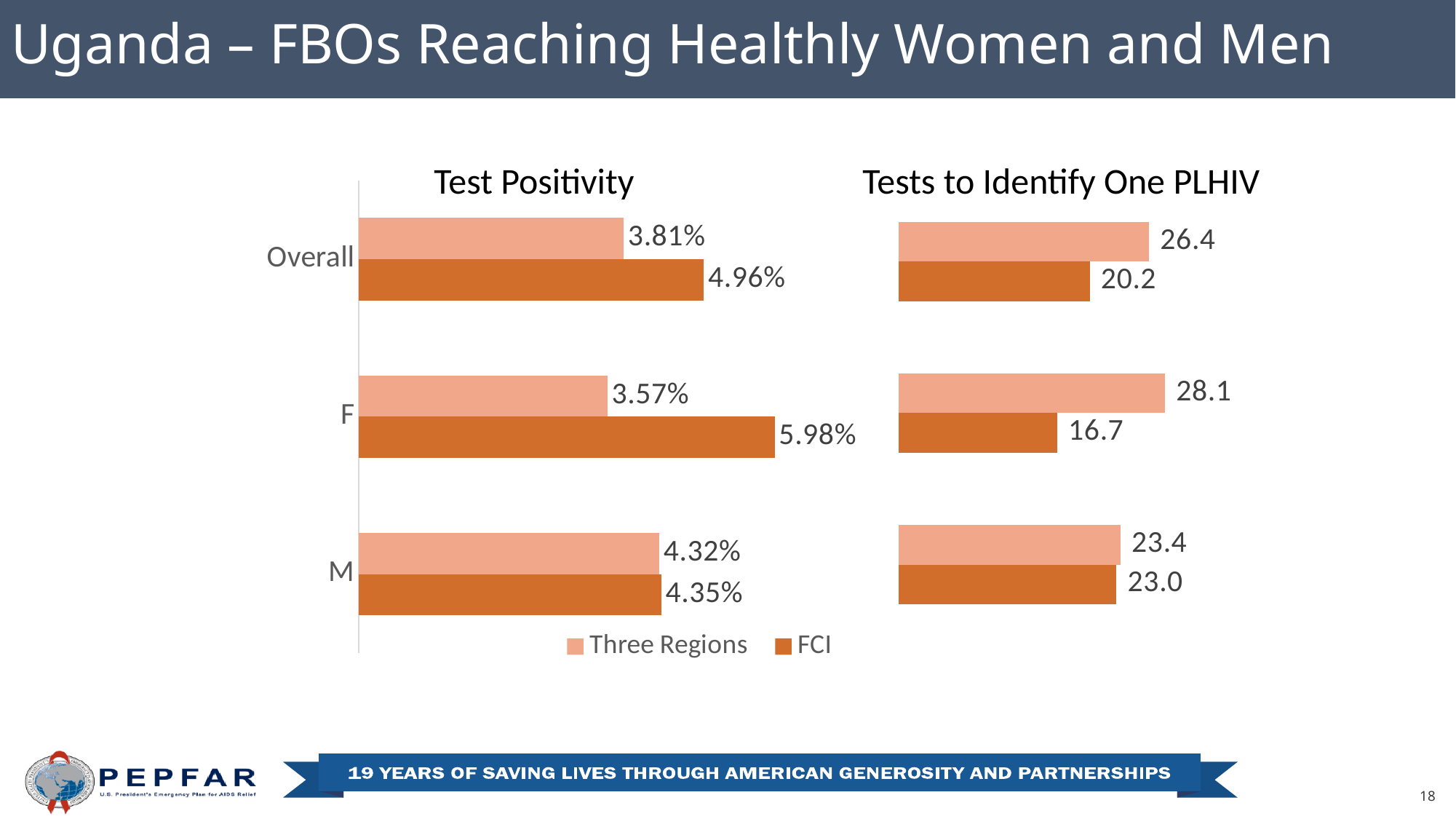
In the Tests to Identify One PLHIV chart, which category has the lowest FCI value? F In the Tests to Identify One PLHIV chart, what is the FCI value for F? 16.7 In the Test Positivity chart, what is the FCI value for F? 5.98% How many categories are shown in the Test Positivity chart? 3 In the Test Positivity chart, what is the Three Regions value for Overall? 3.81% In the Test Positivity chart, what is the difference between the FCI and Three Regions values for Overall? 1.15% What kind of chart is the Tests to Identify One PLHIV chart? Bar chart In the Tests to Identify One PLHIV chart, which is larger for Overall: Three Regions or FCI? Three Regions In the Tests to Identify One PLHIV chart, what is the difference between the Three Regions and FCI values for F? 11.4 In the Tests to Identify One PLHIV chart, what is the Three Regions value for M? 23.4 In the Test Positivity chart, which category has the highest FCI value? F How many series does the legend list? 2